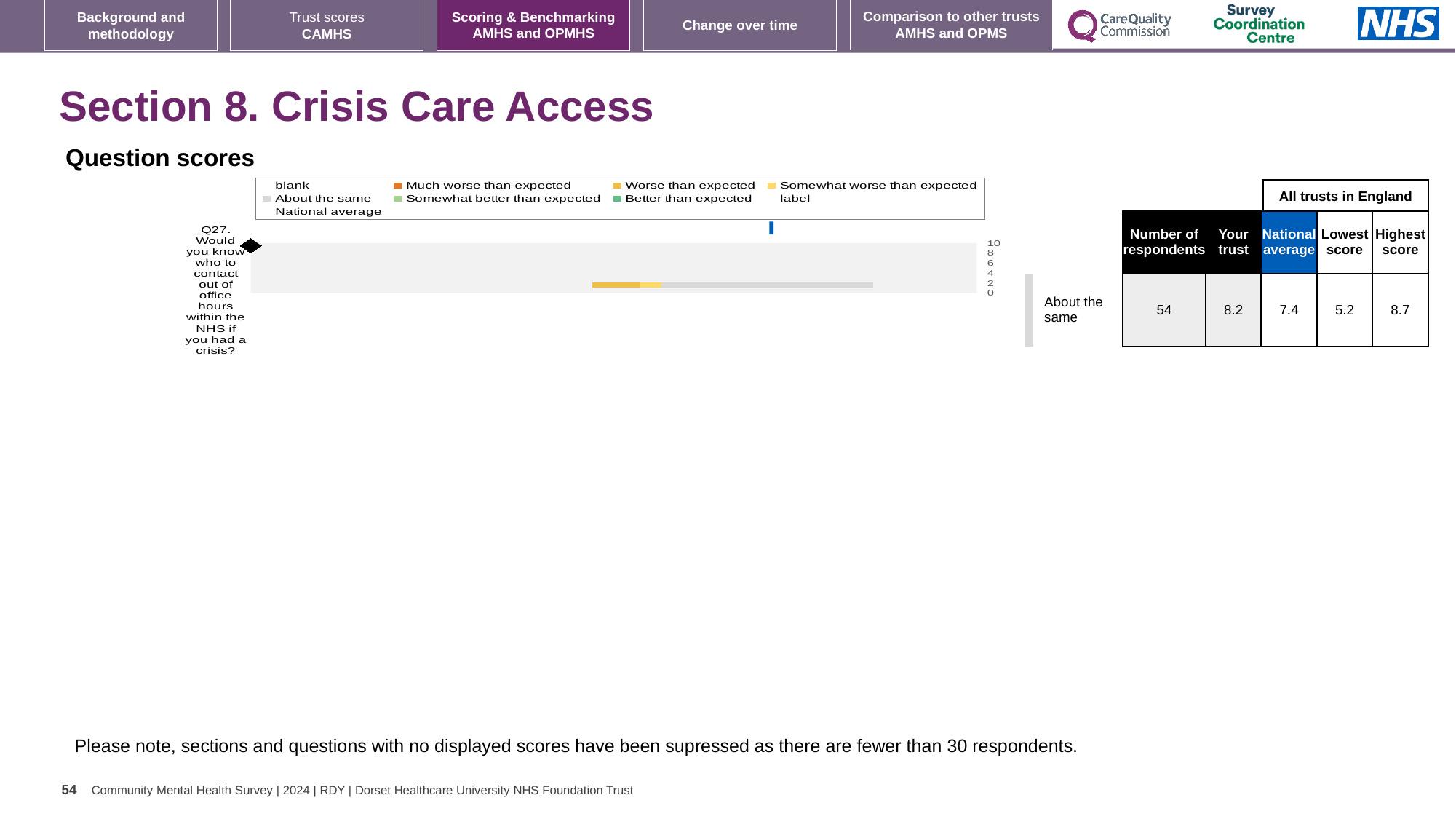
For Q27, which is larger: the 'Your trust' score or the national average? Your trust What is the difference between the highest and lowest scores for Q27 across all trusts in England? 3.5 How many respondents answered Q27? 54 By how much does the trust's Q27 score exceed the national average? 0.8 What is the national average score for Q27? 7.4 How many questions are plotted in the Question scores chart? 1 What is the lowest score among all trusts in England for Q27? 5.2 What is the 'Your trust' score for Q27 (knowing who to contact out of office hours in a crisis)? 8.2 What is the highest score among all trusts in England for Q27? 8.7 What is the maximum value shown on the chart's score axis? 10 What kind of chart is used to show the Q27 question score? bar chart What benchmark category label is shown next to the Q27 bar? About the same